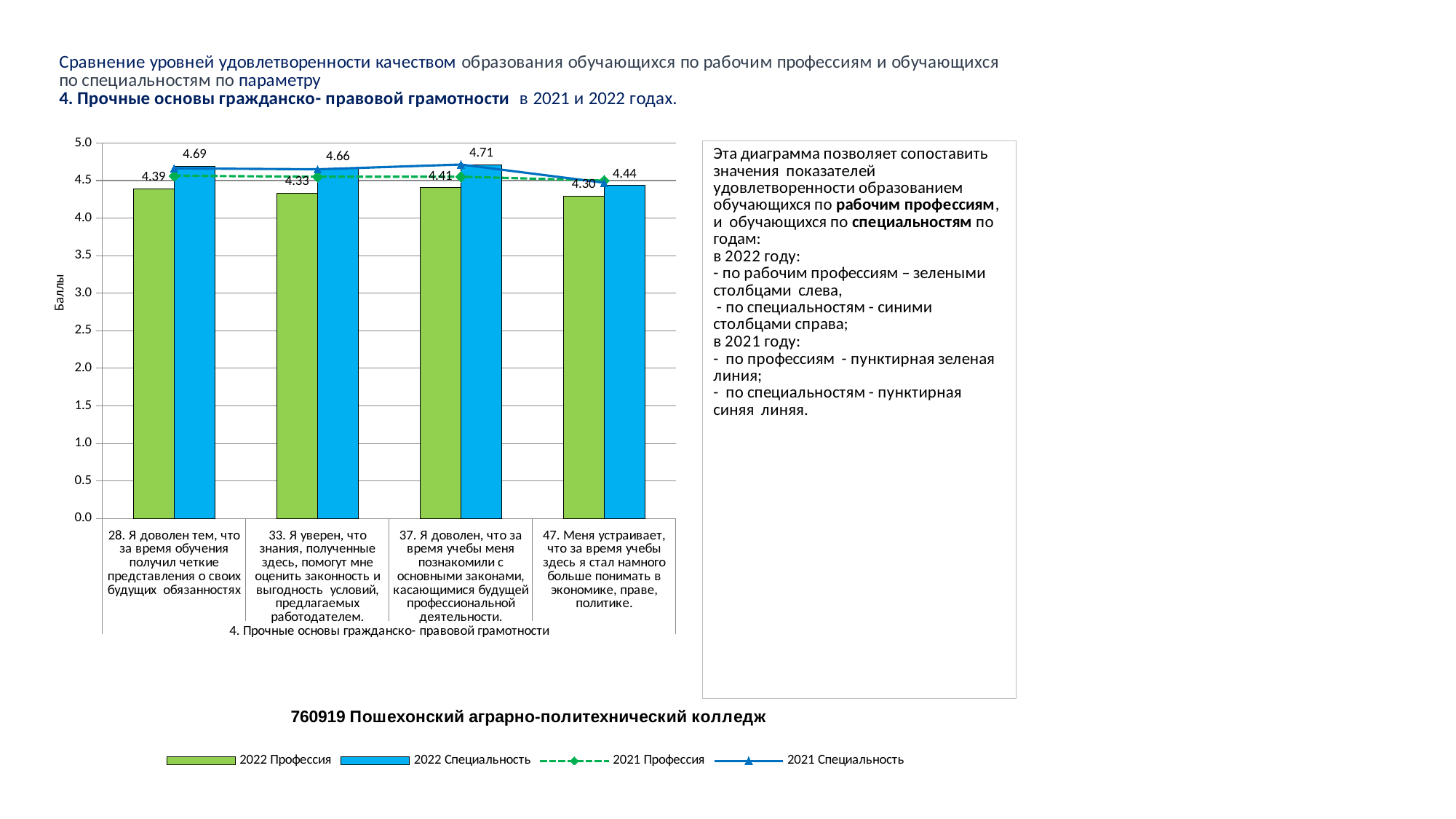
What is the difference between the 2022 Специальность and 2022 Профессия values for category 28? 0.30 What is the value of the 2022 Профессия bar for category 28 (Я доволен тем, что за время обучения получил четкие представления о своих будущих обязанностях)? 4.39 How many categories (questions) are shown on the x axis of the chart? 4 For category 47, which is larger: the 2022 Профессия bar or the 2022 Специальность bar? 2022 Специальность Is the 2021 Профессия line value for category 28 greater or less than 4.0? greater What is the value of the 2022 Специальность bar for category 47 (Меня устраивает, что за время учебы здесь я стал намного больше понимать в экономике, праве, политике)? 4.44 Which category has the lowest 2022 Профессия value? 47. Меня устраивает, что за время учебы здесь я стал намного больше понимать в экономике, праве, политике. What is the label of the y axis of the chart? Баллы How many series does the chart legend list? 4 What is the value of the 2022 Профессия bar for category 33 (Я уверен, что знания, полученные здесь, помогут мне оценить законность и выгодность условий...)? 4.33 Which category has the highest 2022 Специальность value? 37. Я доволен, что за время учебы меня познакомили с основными законами, касающимися будущей профессиональной деятельности. What is the value of the 2022 Специальность bar for category 37 (Я доволен, что за время учебы меня познакомили с основными законами...)? 4.71